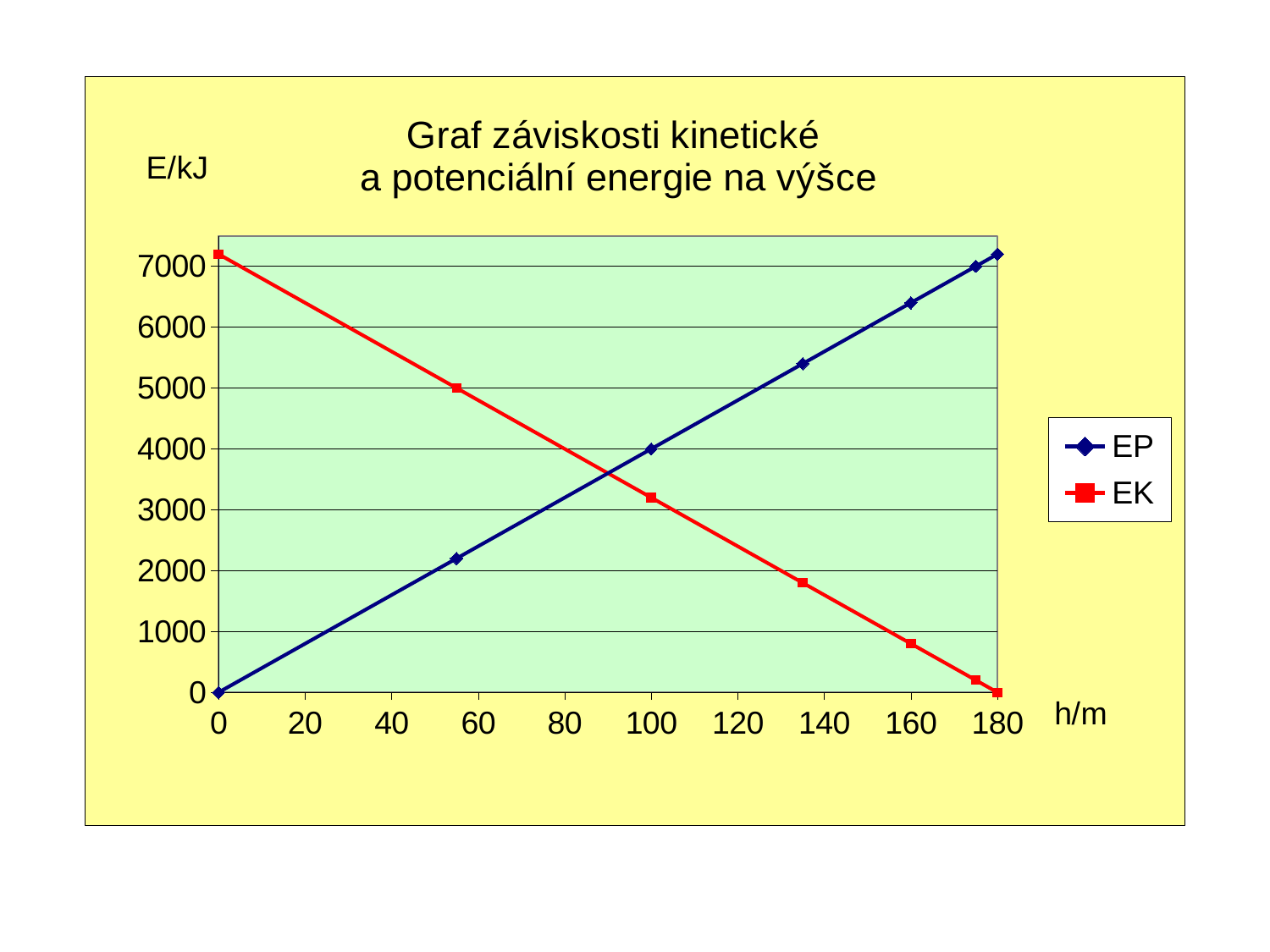
What is the value of EK at h = 180? 0 What is the value of EP at h = 0? 0 Is the value of EK at h = 100 greater or less than 4000? less At h = 135, which series has the larger value, EP or EK? EP Is the value of EP at h = 160 greater or less than 6000? greater How many series does the legend list? 2 What are the names of the two series in the legend? EP and EK Does the EK series rise or fall as h increases along the x axis? fall What kind of chart is shown on the slide? line chart At h = 55, which series has the larger value, EP or EK? EK Does the EP series rise or fall as h increases along the x axis? rise What is the title of the chart? Graf záviskosti kinetické a potenciální energie na výšce